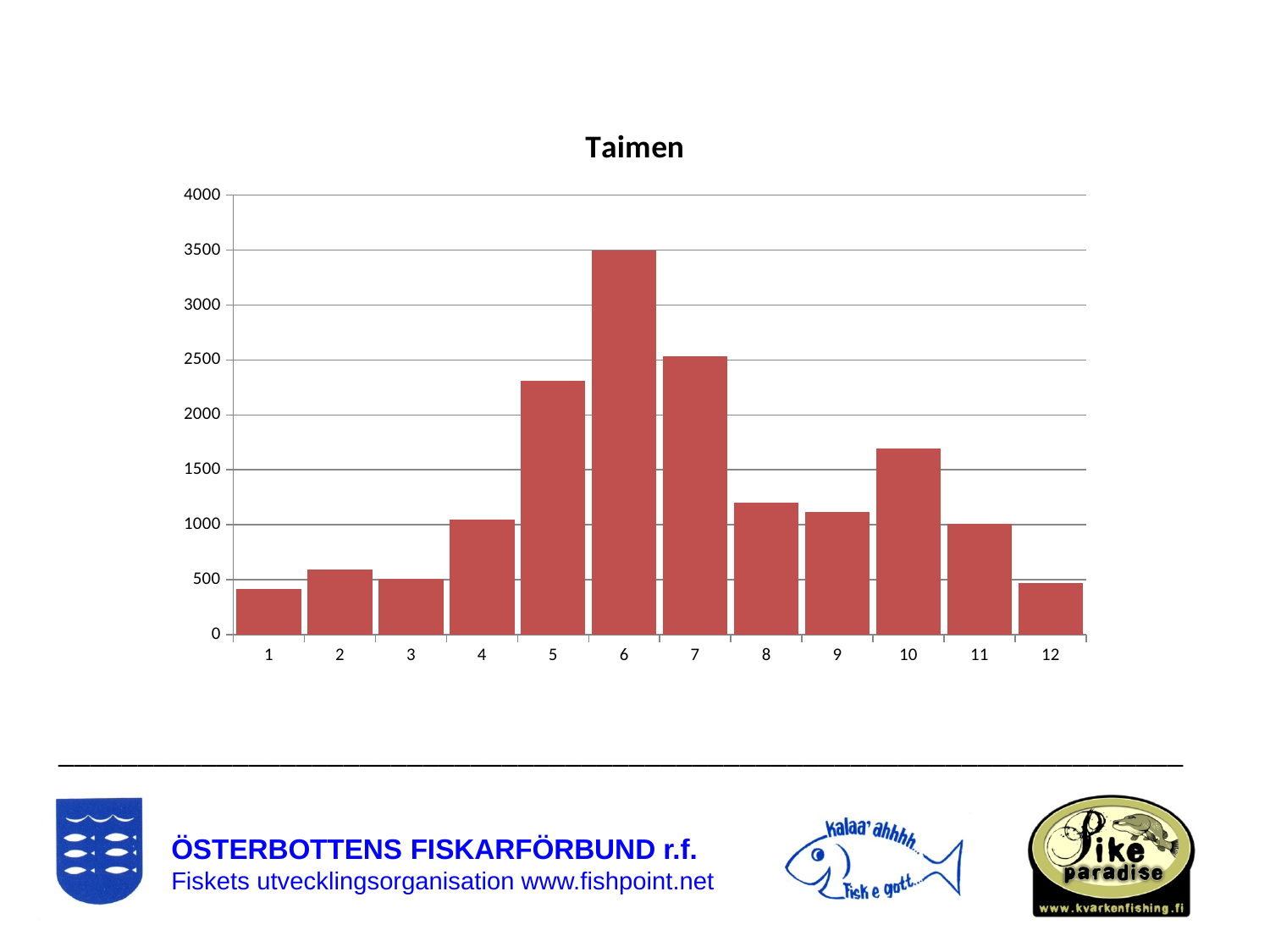
What is the title of the chart? Taimen Do the values rise or fall from category 1 to category 6? rise What kind of chart is shown on the slide? bar chart Is the value for category 6 greater or less than 3000? greater Which has the larger value, category 5 or category 7? 7 Is the value for category 10 greater or less than 1500? greater Which category has the highest bar in the chart? 6 Which has the larger value, category 4 or category 10? 10 How many categories are shown on the x axis of the chart? 12 Is the value for category 8 greater or less than 1500? less